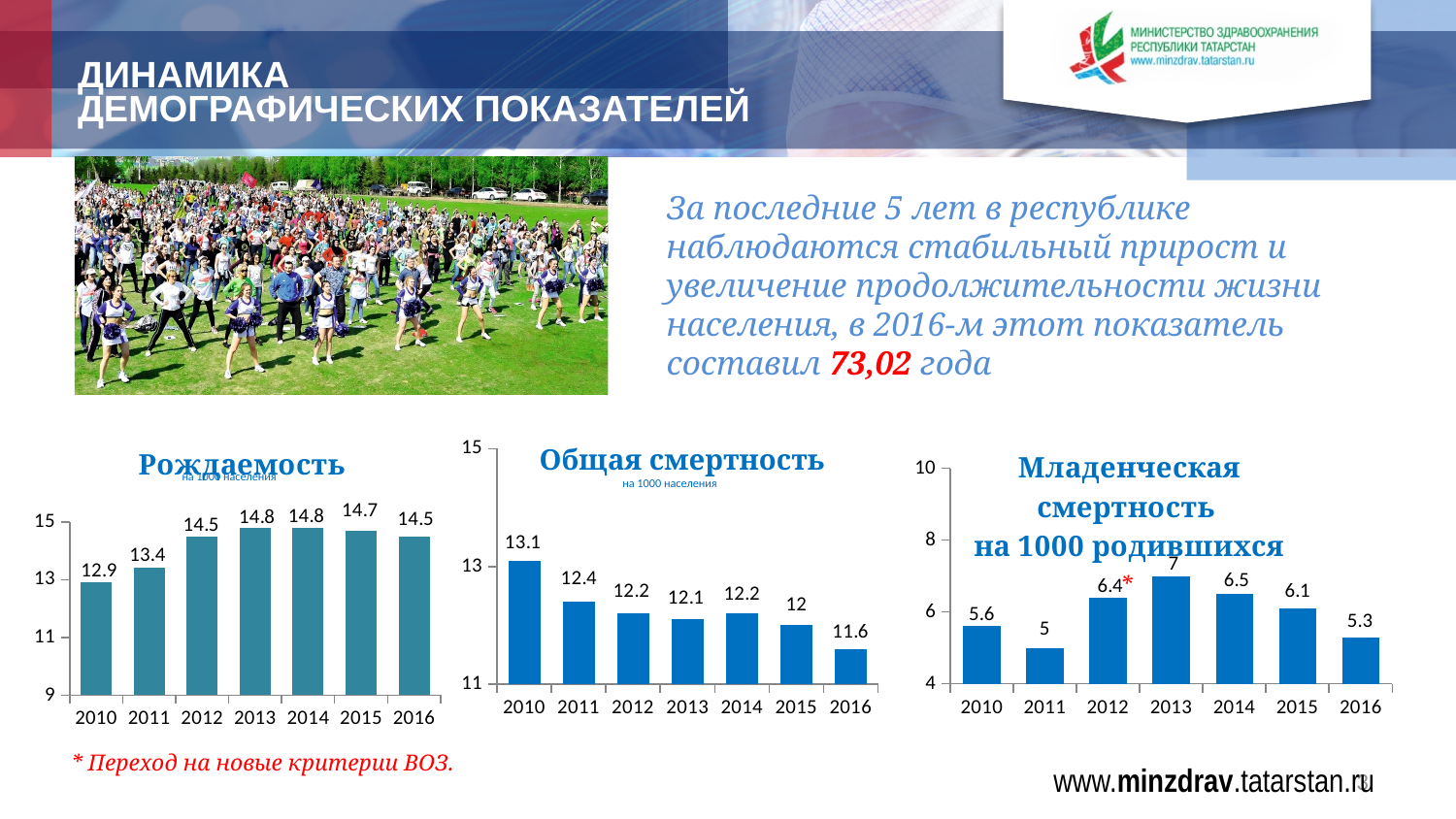
In the "Рождаемость" chart, which year has the lowest value? 2010 In the "Общая смертность" chart, what is the value for 2016? 11.6 In the "Общая смертность" chart, what is the difference between the values for 2010 and 2016? 1.5 How many years are shown on the x axis of the "Рождаемость" chart? 7 In the "Рождаемость" chart, what is the difference between the values for 2012 and 2010? 1.6 In the "Общая смертность" chart, which year has the highest value? 2010 What type of chart is the "Общая смертность" chart? bar chart In the "Рождаемость" chart, what is the value for 2010? 12.9 In the "Общая смертность" chart, do the values generally rise or fall from 2010 to 2016? fall In the "Младенческая смертность на 1000 родившихся" chart, what is the value for 2013? 7 In the "Младенческая смертность на 1000 родившихся" chart, which is larger, the value for 2014 or the value for 2015? 2014 In the "Младенческая смертность на 1000 родившихся" chart, which year has the lowest value? 2011